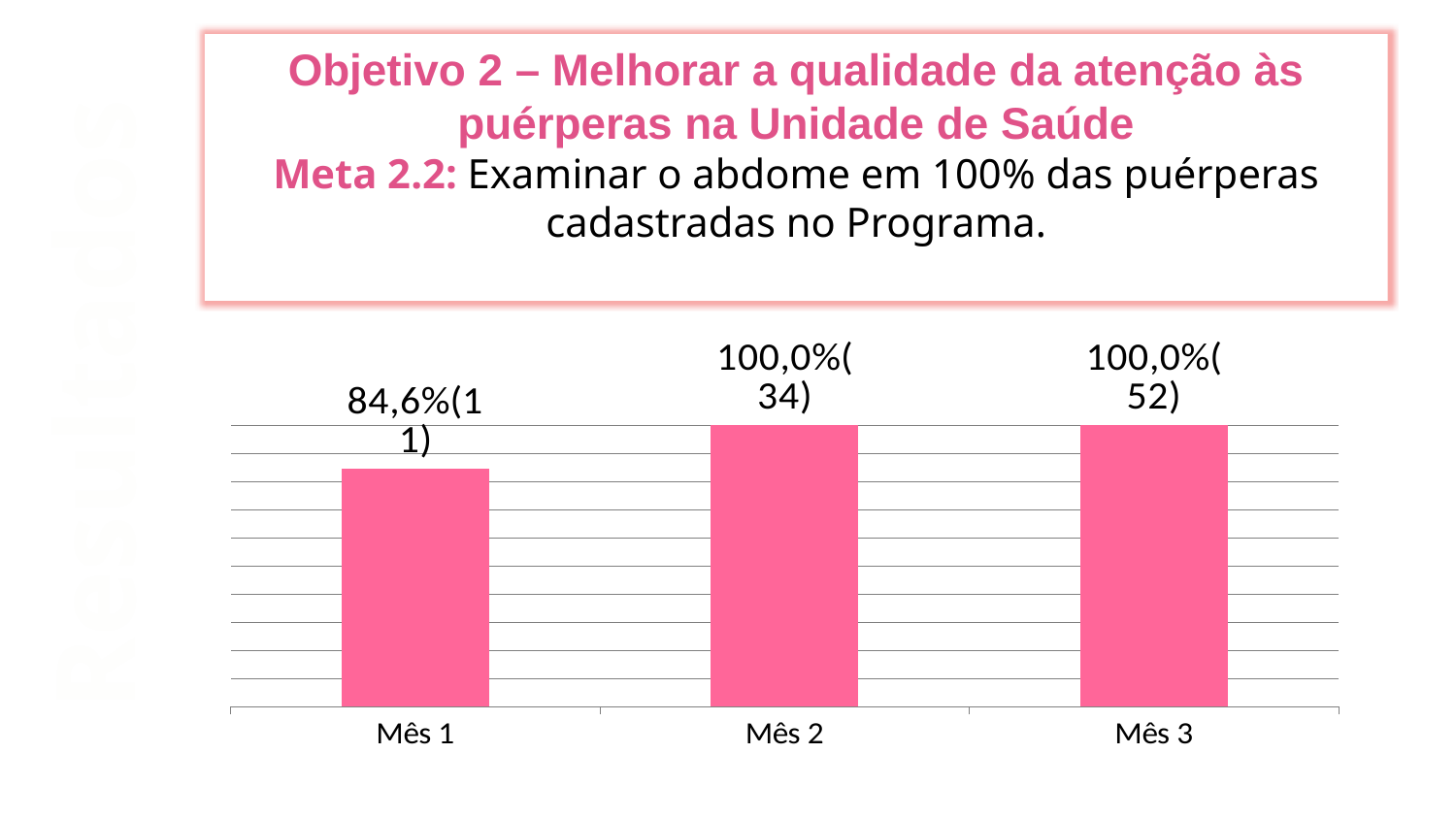
Which is larger, the percentage for Mês 1 or Mês 3? Mês 3 What colour are the bars in the chart? Pink How many puérperas are shown in parentheses for Mês 3? 52 What is the difference in percentage between Mês 2 and Mês 1? 15,4% How many puérperas are shown in parentheses for Mês 1? 11 What kind of chart is shown on the slide? Bar chart What is the value shown for Mês 1? 84,6% How many months (categories) are shown in the chart? 3 What is the value shown for Mês 2? 100,0% Do the percentages rise or fall from Mês 1 to Mês 2? Rise Which month has the lowest percentage? Mês 1 What is the value shown for Mês 3? 100,0%